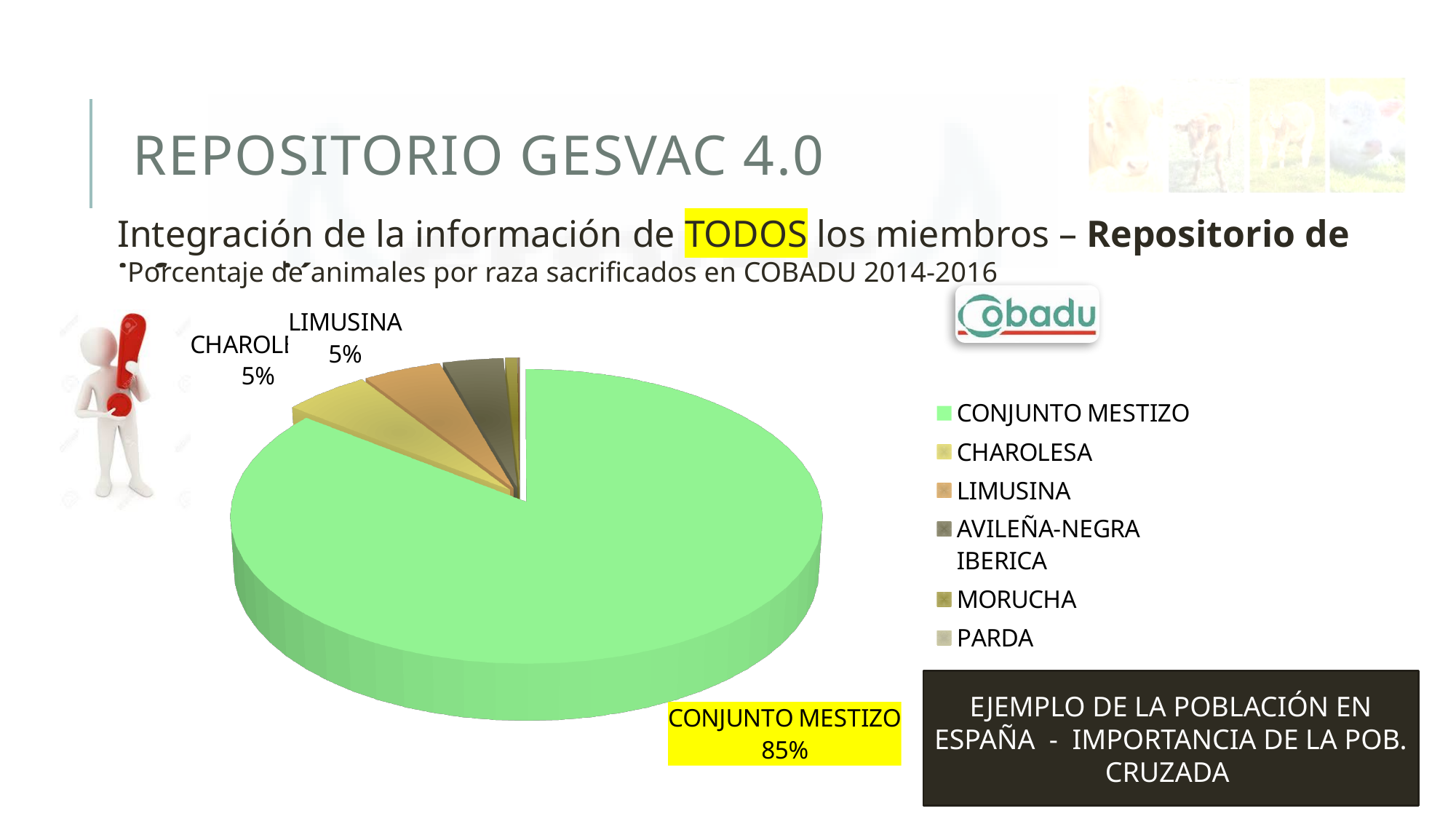
What is the combined percentage of CHAROLESA and LIMUSINA in the pie chart? 10% What kind of chart is shown on the slide? pie chart Which category has the largest slice in the pie chart? CONJUNTO MESTIZO What is the value shown for LIMUSINA in the pie chart? 5% What is the title of the pie chart? Porcentaje de animales por raza sacrificados en COBADU 2014-2016 What is the difference in percentage points between CONJUNTO MESTIZO and LIMUSINA? 80 How many categories does the legend of the pie chart list? 6 What colour is the CONJUNTO MESTIZO slice in the pie chart? green What is the value shown for CHAROLESA in the pie chart? 5% Which is larger in the pie chart, CONJUNTO MESTIZO or CHAROLESA? CONJUNTO MESTIZO What percentage of the pie chart does CONJUNTO MESTIZO represent? 85%